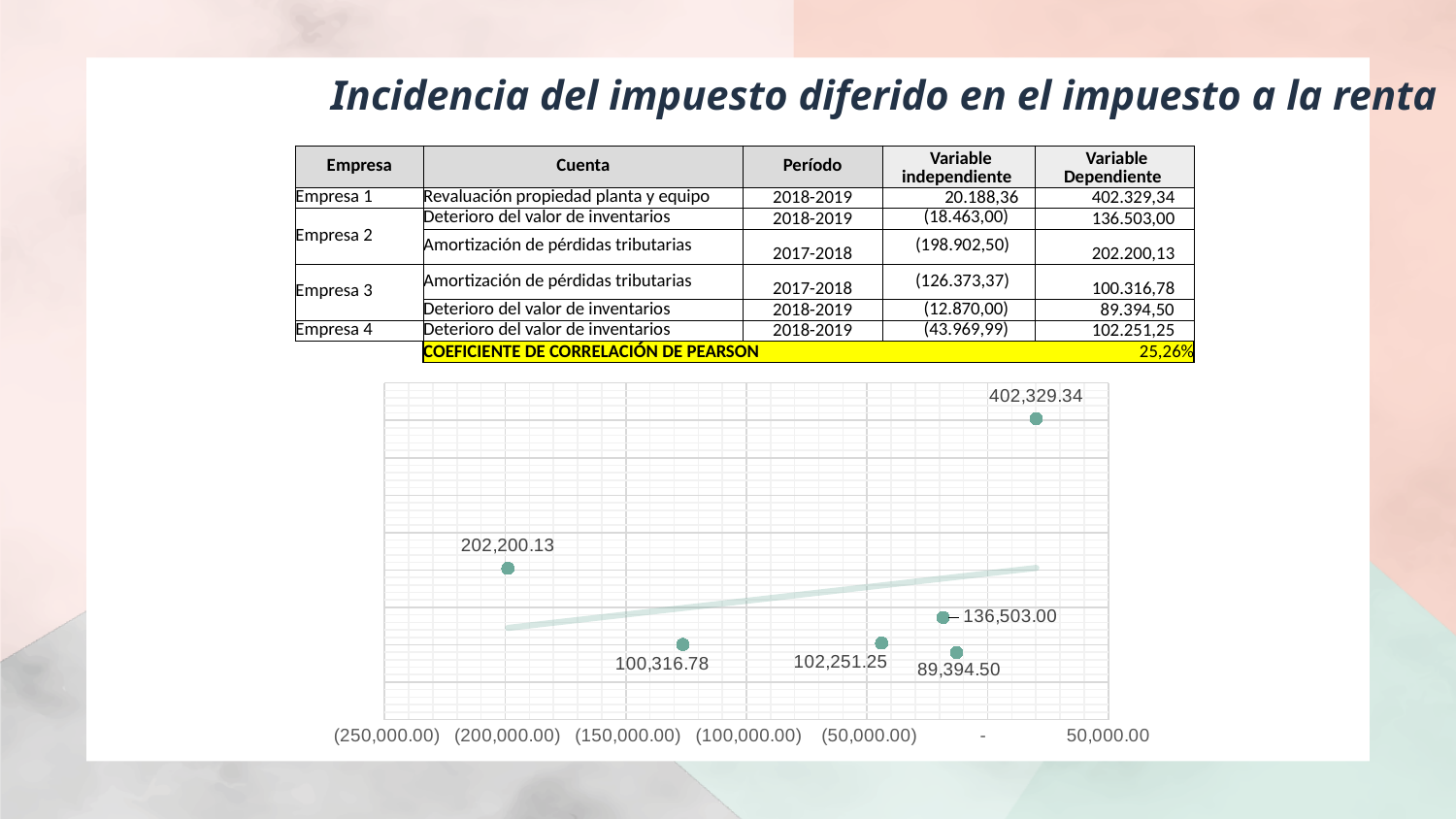
What kind of chart is shown on the slide? scatter chart Does the trend line in the chart rise or fall from left to right? rises Is the x-axis value of the point labeled 402,329.34 greater or less than 0 (the '-' tick)? greater How many data points are plotted in the chart? 6 What is the highest labeled value among the plotted points? 402,329.34 Does the chart include a trend line? yes What is the difference between the point labeled 136,503.00 and the point labeled 89,394.50? 47,108.50 Is the x-axis value of the point labeled 202,200.13 greater or less than (150,000.00)? less What is the data label of the leftmost point in the chart? 202,200.13 What is the lowest labeled value among the plotted points? 89,394.50 Which is larger, the point labeled 100,316.78 or the point labeled 102,251.25? 102,251.25 What is the difference between the point labeled 402,329.34 and the point labeled 202,200.13? 200,129.21